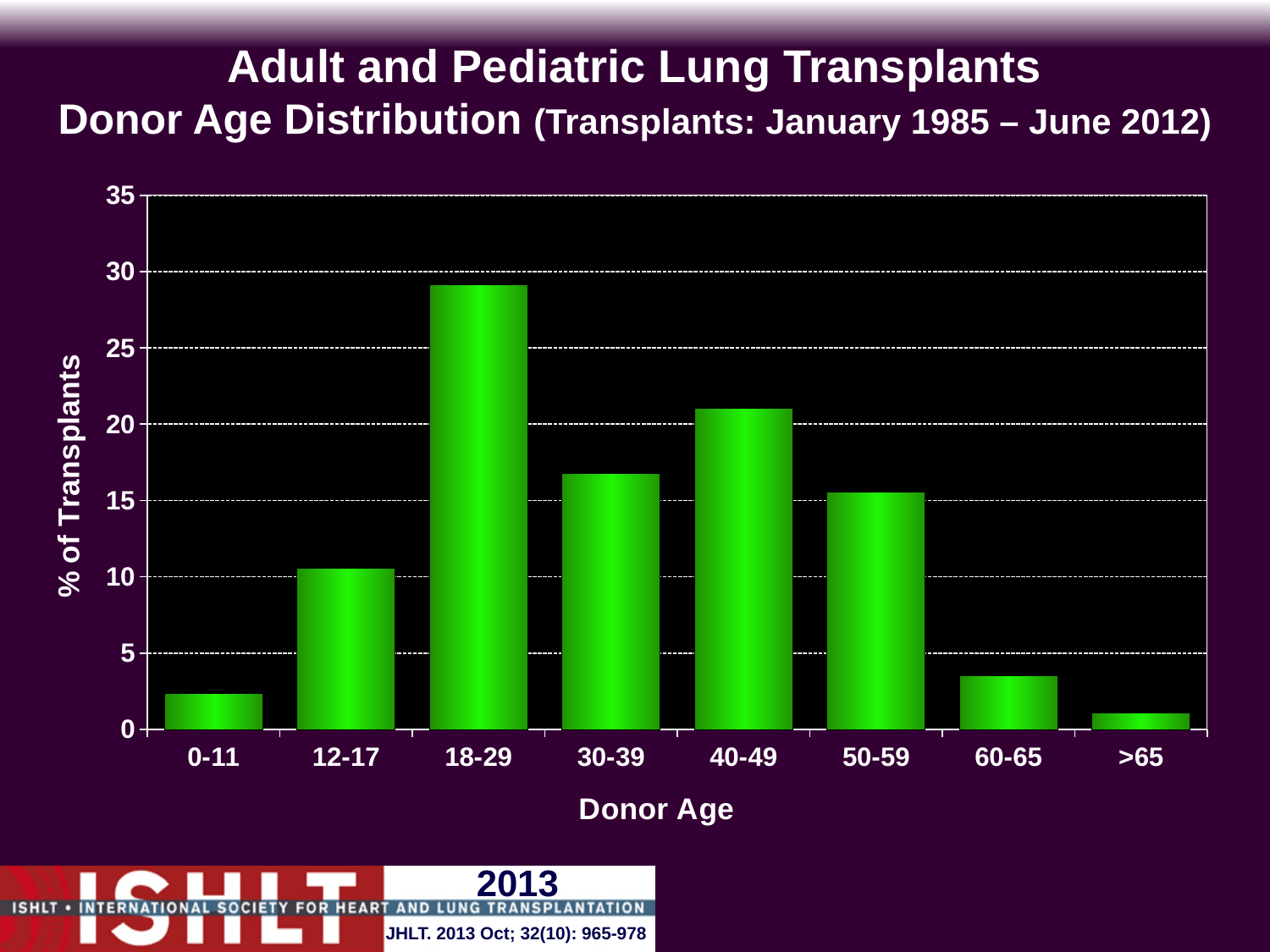
Is the value for the 50-59 donor age group greater or less than 20? less Which has a higher percentage of transplants, the 12-17 or the 60-65 donor age group? 12-17 Is the value for the 18-29 donor age group greater or less than 25? greater Is the value for the 0-11 donor age group greater or less than 5? less How many donor age categories are shown on the x axis? 8 Which has a higher percentage of transplants, the 18-29 or the 40-49 donor age group? 18-29 Which donor age group has the highest percentage of transplants? 18-29 Which donor age group has the lowest percentage of transplants? >65 What is the label of the y axis? % of Transplants What type of chart is shown on the slide? bar chart